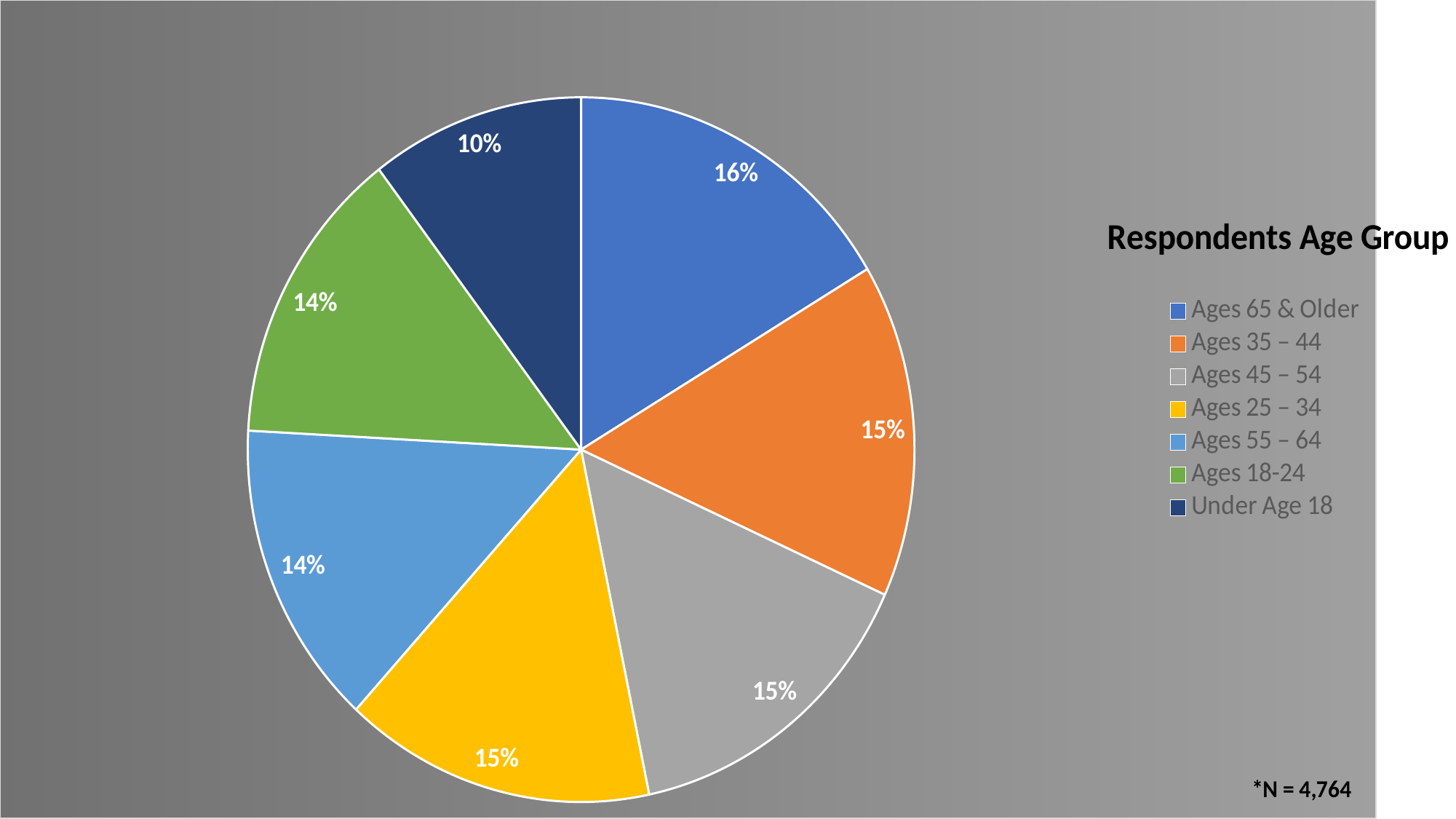
Which is larger, the share for Ages 55 – 64 or the share for Ages 35 – 44? Ages 35 – 44 What percentage of respondents are Ages 25 – 34? 15% What is the title of the chart? Respondents Age Group Which age group has the smallest share of respondents? Under Age 18 Which age group has the largest share of respondents? Ages 65 & Older What is the difference in percentage points between Ages 65 & Older and Under Age 18? 6 How many slices does the pie chart have? 7 What percentage of respondents are Under Age 18? 10% What type of chart is shown on the slide? pie chart What percentage of respondents are Ages 65 & Older? 16% What is the sample size (N) noted on the slide? 4,764 What percentage of respondents are Ages 18-24? 14%